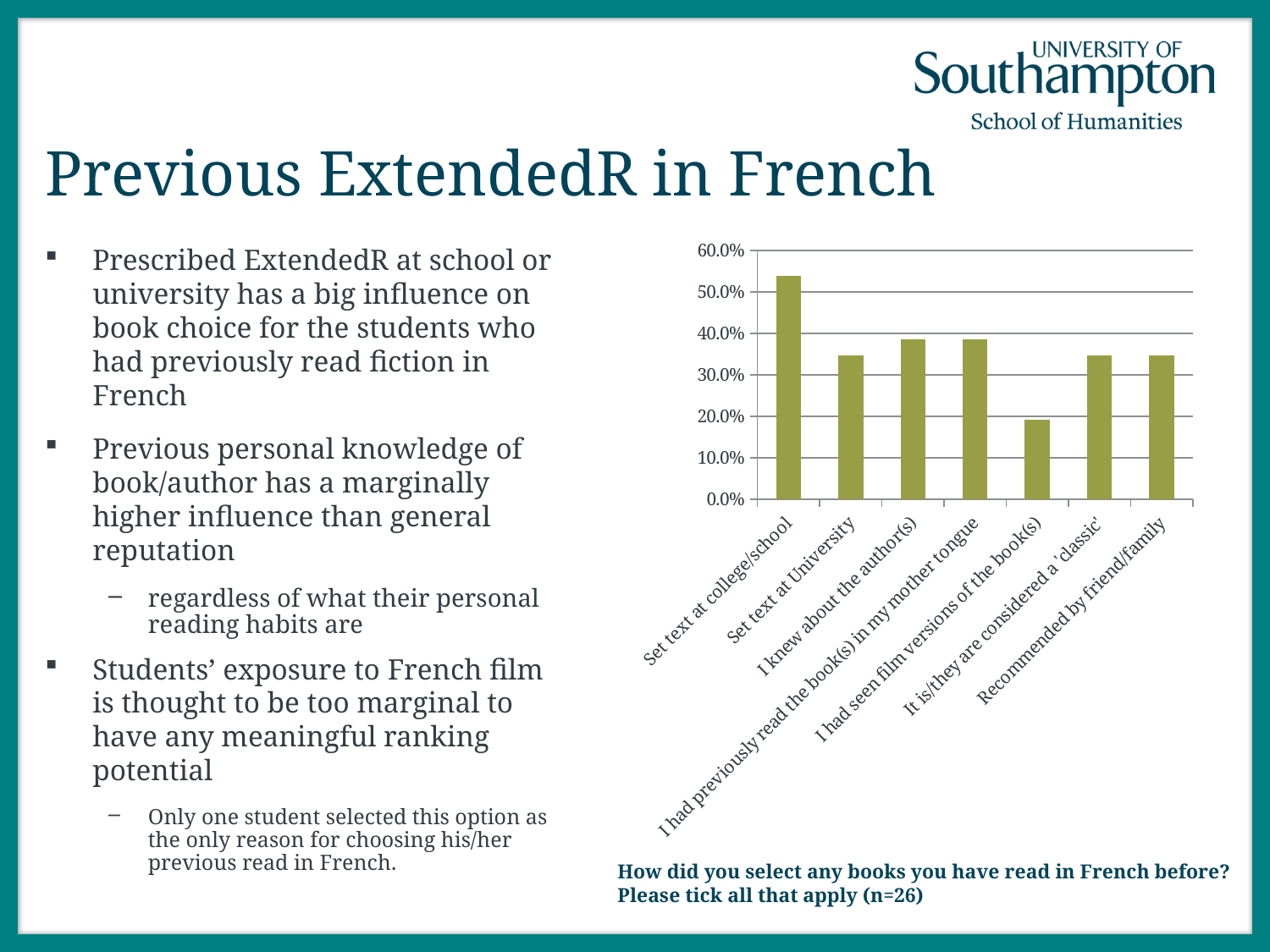
According to the caption below the chart, how many respondents (n) answered the question? 26 How many categories are plotted in the chart? 7 Is the value for 'Set text at college/school' greater or less than 50%? greater Is the value for 'Set text at University' greater or less than 30%? greater Which is larger: the value for 'I had seen film versions of the book(s)' or the value for 'It is/they are considered a 'classic''? It is/they are considered a 'classic' What kind of chart is shown on the slide? bar chart Which is larger: the value for 'Set text at college/school' or the value for 'Set text at University'? Set text at college/school Which category has the lowest value in the chart? I had seen film versions of the book(s) Which category has the highest value in the chart? Set text at college/school What is the highest value shown on the chart's vertical axis? 60.0%